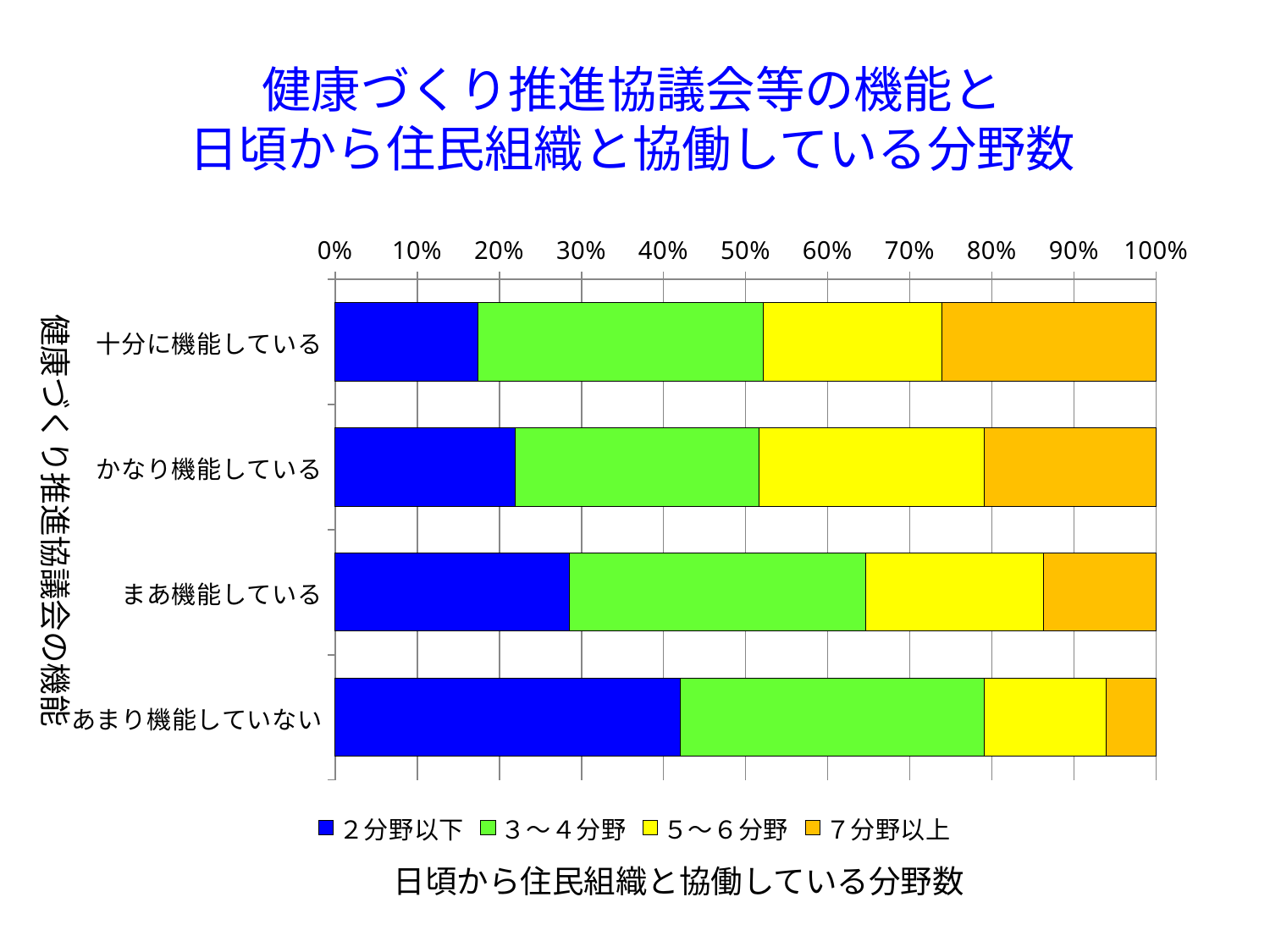
Which category has the smallest 7分野以上 (orange) segment? あまり機能していない Is the 7分野以上 share for あまり機能していない greater or less than 10%? less Is the 2分野以下 share for 十分に機能している greater or less than 20%? less Going from 十分に機能している down to あまり機能していない, does the 2分野以下 (blue) segment get larger or smaller? larger How many series does the legend list? 4 Is the 2分野以下 share for あまり機能していない greater or less than 40%? greater Which category has the largest 7分野以上 (orange) segment? 十分に機能している What is the title of the horizontal axis below the legend? 日頃から住民組織と協働している分野数 What kind of chart is shown on the slide? Stacked bar chart How many categories (rows) are plotted on the vertical axis? 4 Which category has the smallest 2分野以下 (blue) segment? 十分に機能している Which category has the largest 2分野以下 (blue) segment? あまり機能していない